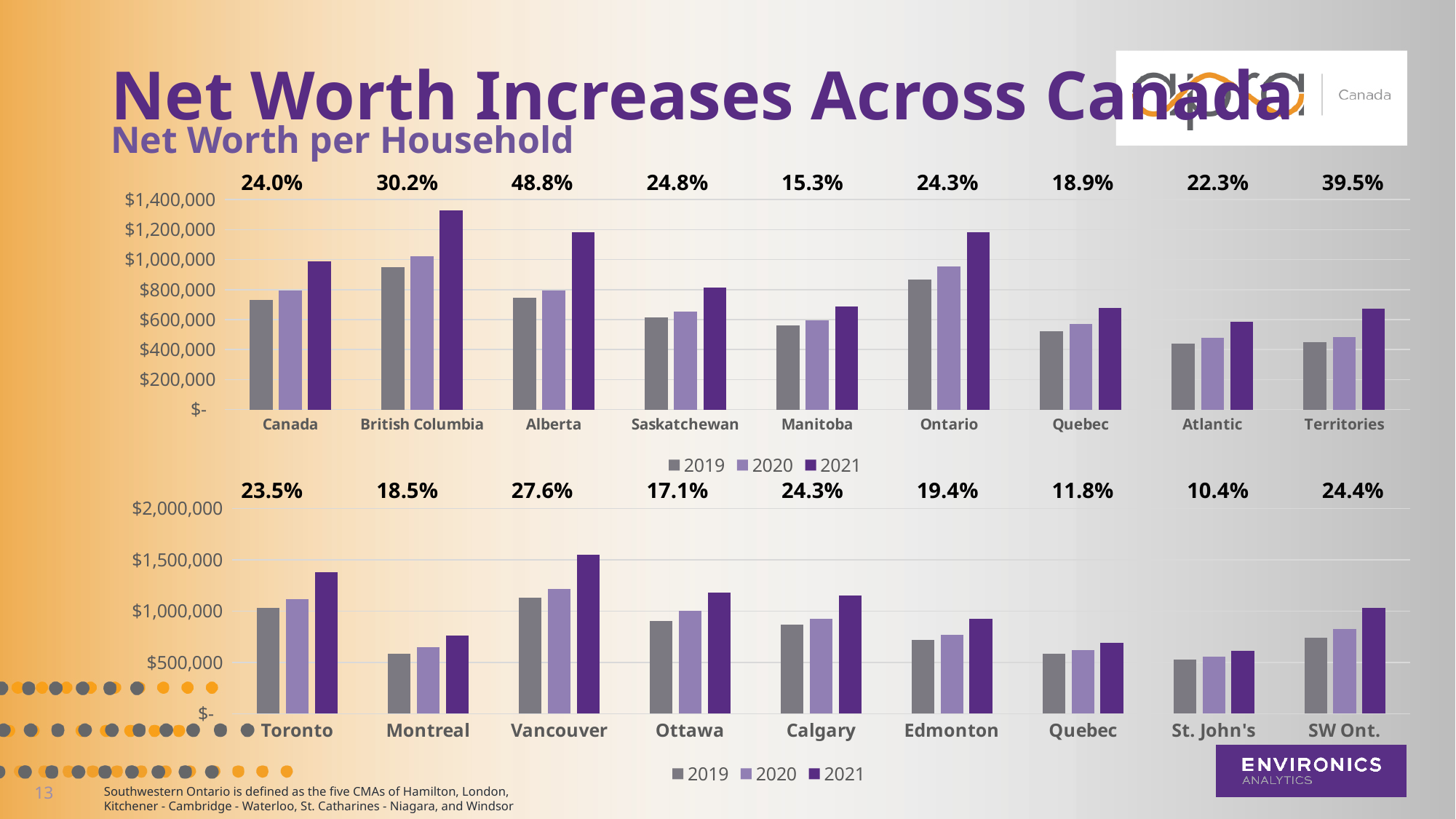
In the top chart, which is larger: the 2021 bar for British Columbia or the 2021 bar for Quebec? British Columbia In the bottom chart, what percentage is printed above the Vancouver group? 27.6% In the bottom chart, which category has the lowest printed percentage? St. John's In the top chart, is the 2021 bar for British Columbia greater or less than $1,200,000? greater In the top chart, what is the difference between the printed percentages for Alberta and Manitoba? 33.5 percentage points In the top chart, how many series does the legend list? 3 In the bottom chart, do the bars for Toronto rise or fall from 2019 to 2021? Rise In the bottom chart, is the 2021 bar for Vancouver greater or less than $1,500,000? greater In the bottom chart, how many categories are shown on the x axis? 9 In the top chart, what percentage is printed above the Alberta group? 48.8% What type of chart is the bottom chart? Bar chart In the top chart, which category has the highest printed percentage? Alberta